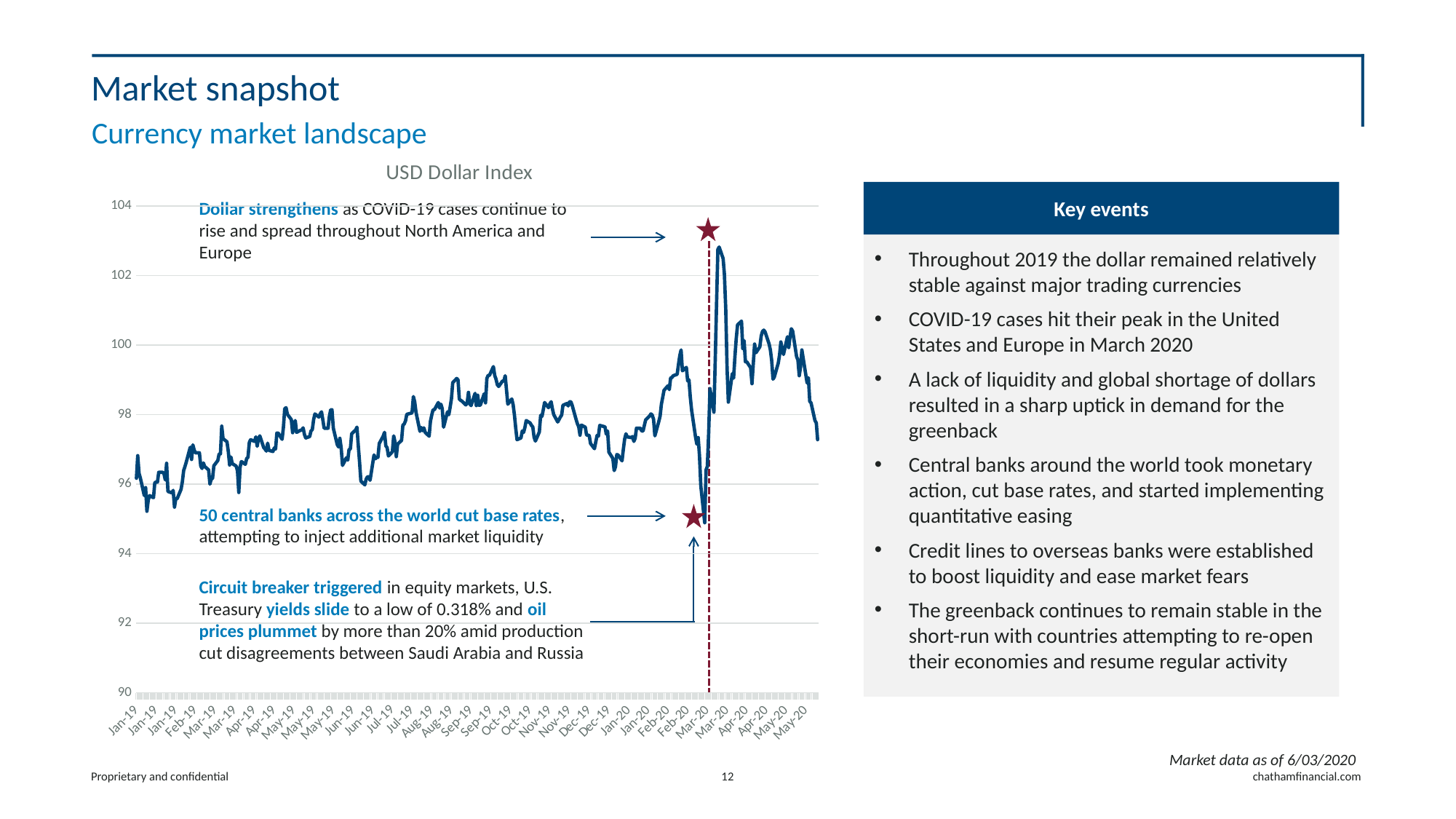
Is the value of the USD Dollar Index at the start of the chart in Jan-19 greater or less than 98? less Is the value of the USD Dollar Index at the end of the chart in May-20 greater or less than 98? less Does the USD Dollar Index rise or fall from its Mar-20 peak to the end of the chart in May-20? fall In which month does the USD Dollar Index reach its highest value on the chart? Mar-20 Is the peak value of the USD Dollar Index in Mar-20 greater or less than 102? greater What kind of chart is shown on the slide? line chart Which is larger: the USD Dollar Index peak in Mar-20 or its peak in Sep-19? Mar-20 What is the title of the chart? USD Dollar Index What is the lowest value shown on the chart's vertical axis? 90 How many series does the chart plot? 1